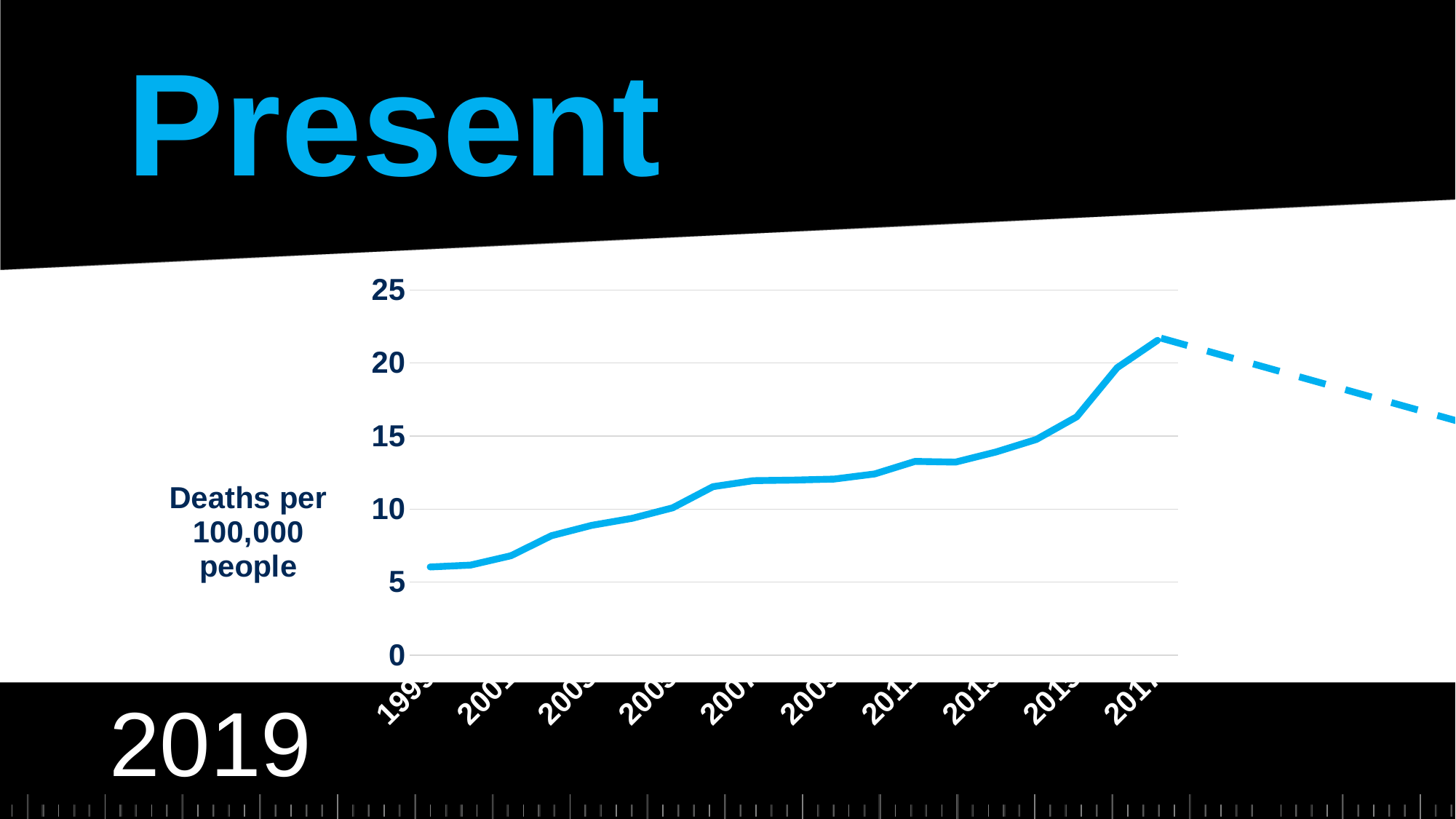
What does the vertical axis of the chart measure? Deaths per 100,000 people Is the value for 1999 greater or less than 10? less Is the value for 2017 greater or less than 20? greater Is the value for 1999 greater or less than 5? greater Do the values on the solid line generally rise or fall from 1999 to 2017? rise Which year has a larger value, 2015 or 2003? 2015 Which year on the x axis has the lowest value on the solid line? 1999 What kind of chart is shown on the slide? line chart What is the highest tick value shown on the vertical axis? 25 Which year on the x axis has the highest value on the solid line? 2017